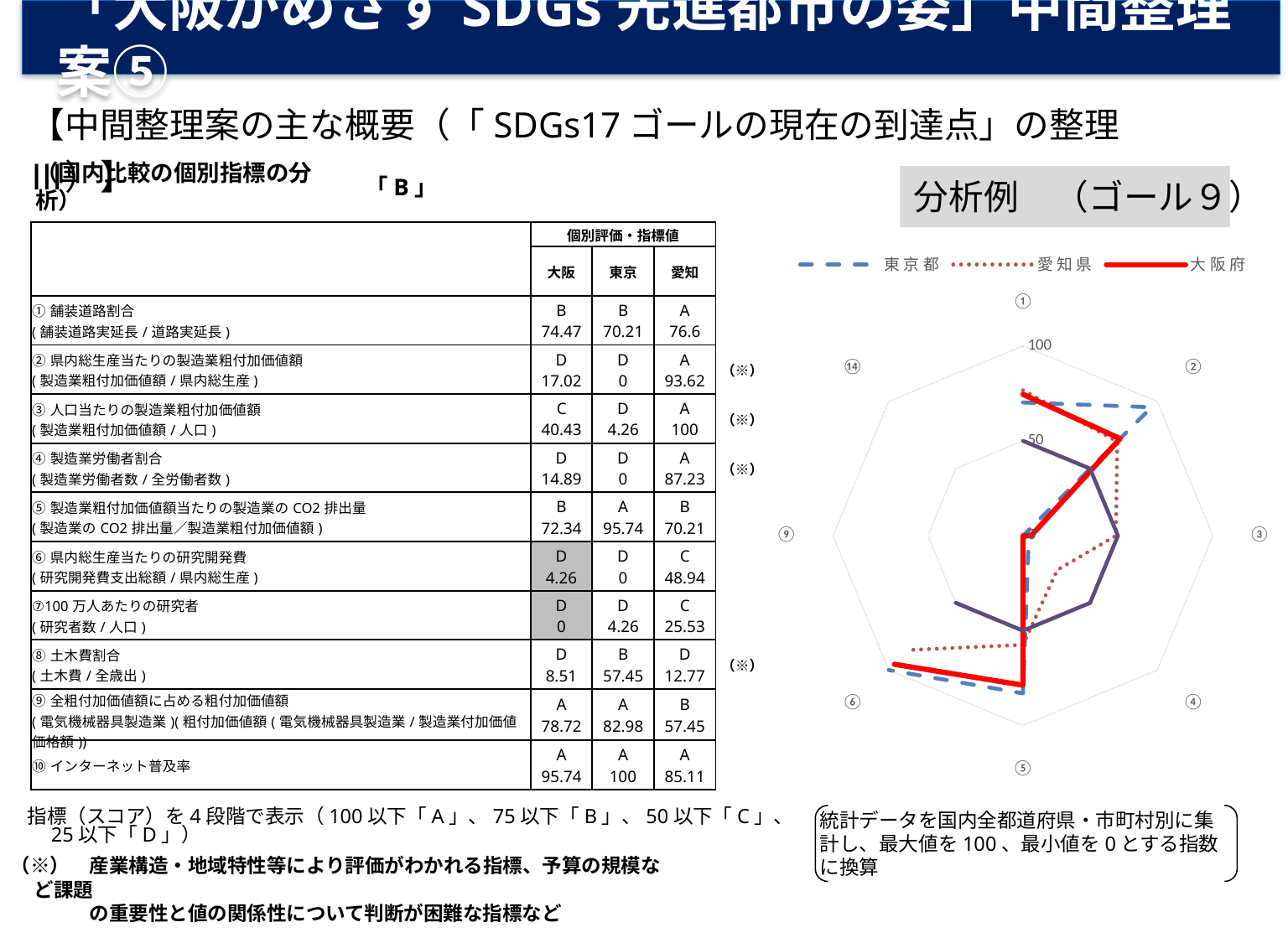
In the radar chart, is the value for 東京都 on axis ② greater or less than 50? greater In the radar chart, is the value for 東京都 on axis ⑤ greater or less than 50? greater In the radar chart, is the value for 大阪府 on axis ④ greater or less than 50? less How many axes (categories) does the radar chart have? 8 Which series in the radar chart is drawn with a solid red line? 大阪府 What kind of chart is shown on the right side of the slide? radar chart Which series in the radar chart is drawn with a dashed blue line? 東京都 How many series does the legend of the radar chart list? 3